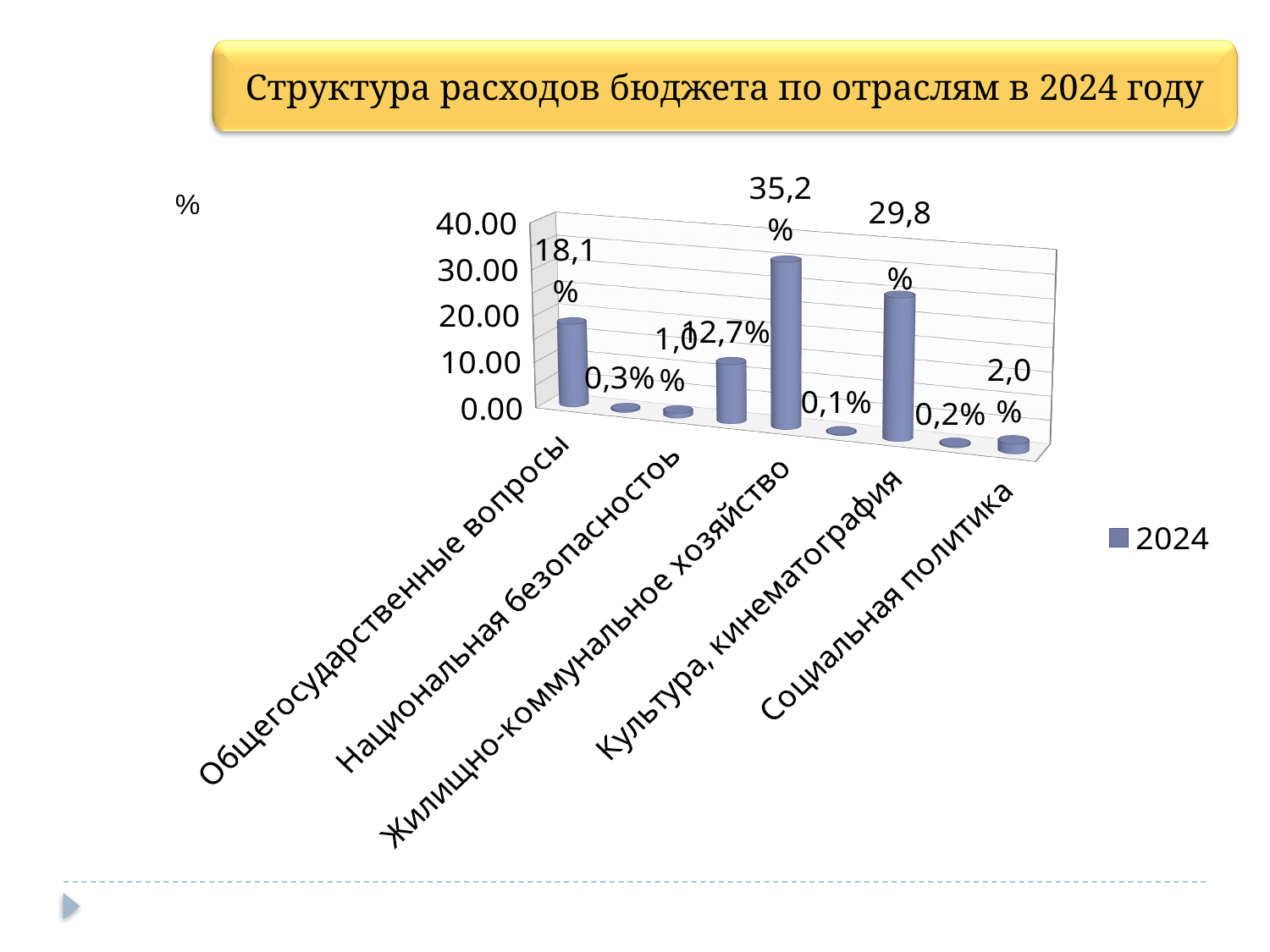
What kind of chart is shown on the slide? bar chart Which is larger, the value for Общегосударственные вопросы or the value for Социальная политика? Общегосударственные вопросы What entry does the legend show? 2024 What is the value for Общегосударственные вопросы? 18,1% What is the value for Жилищно-коммунальное хозяйство? 35,2% What is the value for Социальная политика? 2,0% What is the difference between the values for Жилищно-коммунальное хозяйство and Культура, кинематография? 5,4% How many series does the legend list? 1 Which category has the highest value? Жилищно-коммунальное хозяйство What is the value for Культура, кинематография? 29,8% What is the title of the chart? Структура расходов бюджета по отраслям в 2024 году How many bars are plotted in the chart? 9